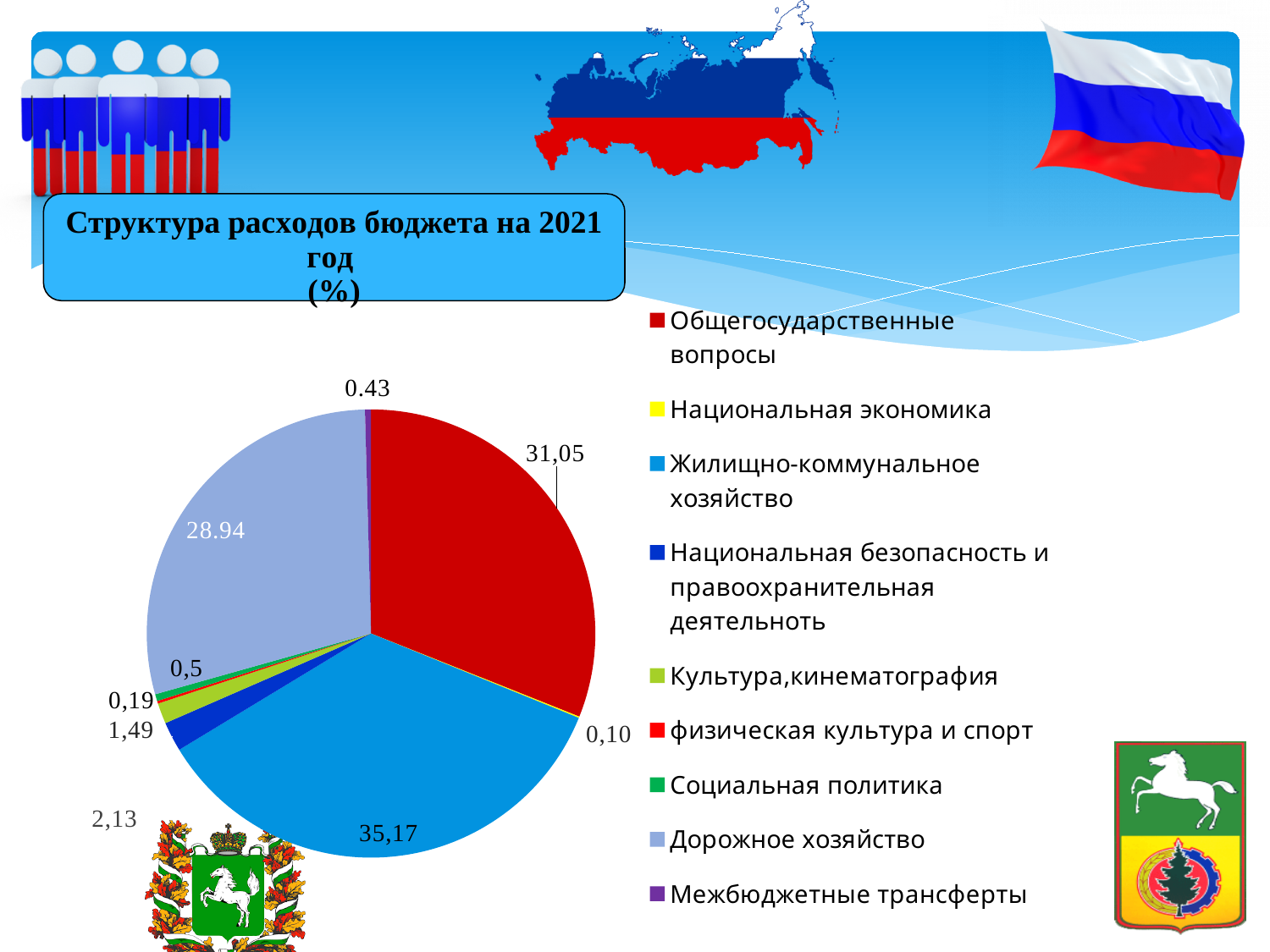
What is the value for Жилищно-коммунальное хозяйство in the pie chart? 35,17 What is the value for Межбюджетные трансферты in the pie chart? 0.43 What kind of chart is shown on the slide? pie chart How many categories does the legend of the pie chart list? 9 What is the title of the chart on the slide? Структура расходов бюджета на 2021 год (%) Which category has the smallest share of the pie chart? Национальная экономика Which is larger in the pie chart: Общегосударственные вопросы or Дорожное хозяйство? Общегосударственные вопросы Which category has the largest share of the pie chart? Жилищно-коммунальное хозяйство What is the difference between the values for Жилищно-коммунальное хозяйство and Общегосударственные вопросы? 4,12 What is the value for Национальная экономика in the pie chart? 0,10 What is the value for Общегосударственные вопросы in the pie chart? 31,05 What is the value for Дорожное хозяйство in the pie chart? 28.94